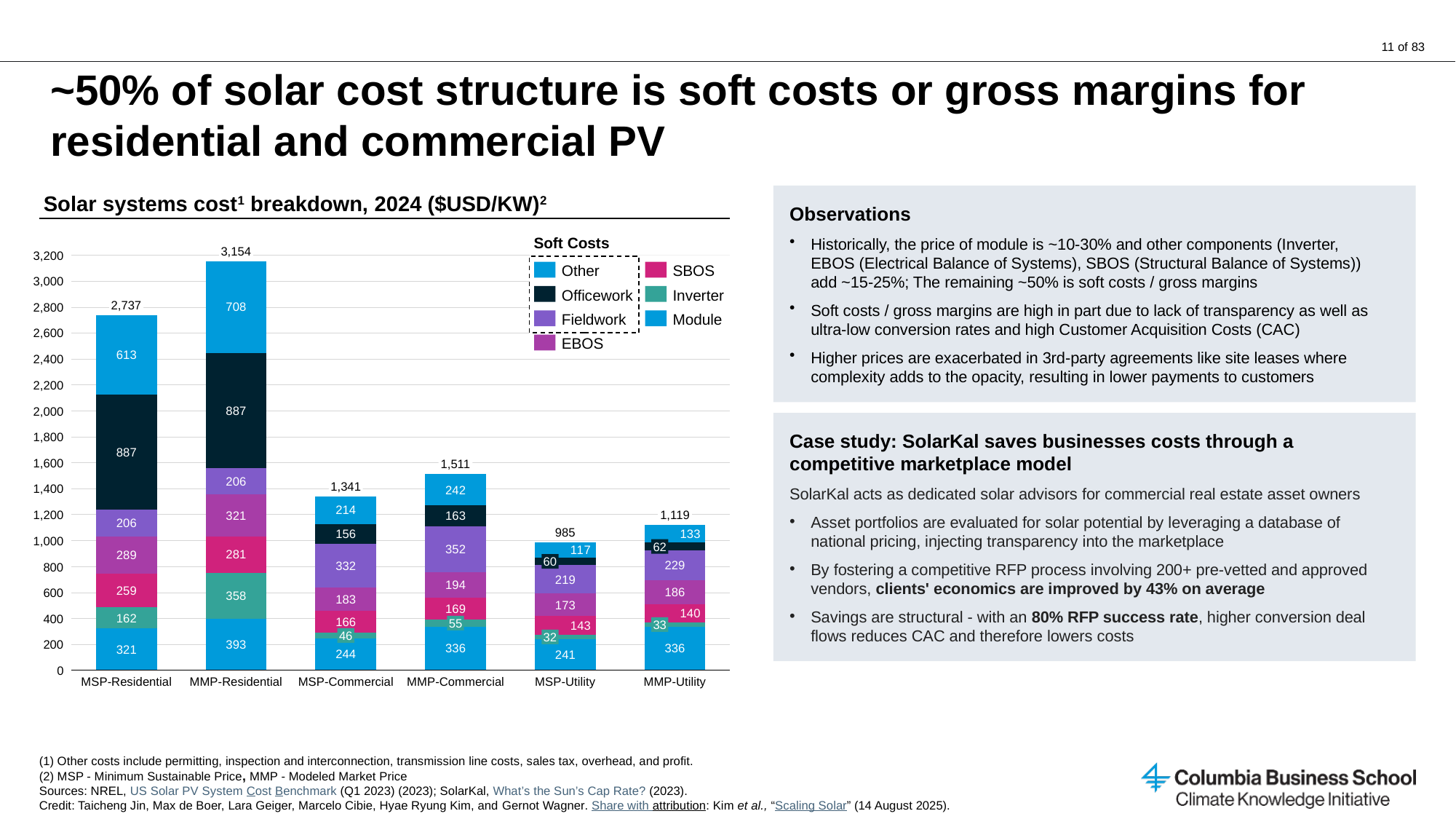
Which category has the highest total cost? MMP-Residential What is the total cost shown for MMP-Residential? 3,154 Which legend entries are grouped under the 'Soft Costs' box? Other, Officework, Fieldwork What is the Module cost for MSP-Commercial? 244 Which has a larger Other cost, MSP-Commercial or MMP-Commercial? MMP-Commercial What is the Officework cost for MSP-Residential? 887 Which category has the lowest total cost? MSP-Utility What is the difference between the total costs of MMP-Residential and MSP-Residential? 417 How many categories are shown on the x axis? 6 What is the Inverter cost for MSP-Utility? 32 What kind of chart is this? Stacked bar chart How many series does the legend list? 7